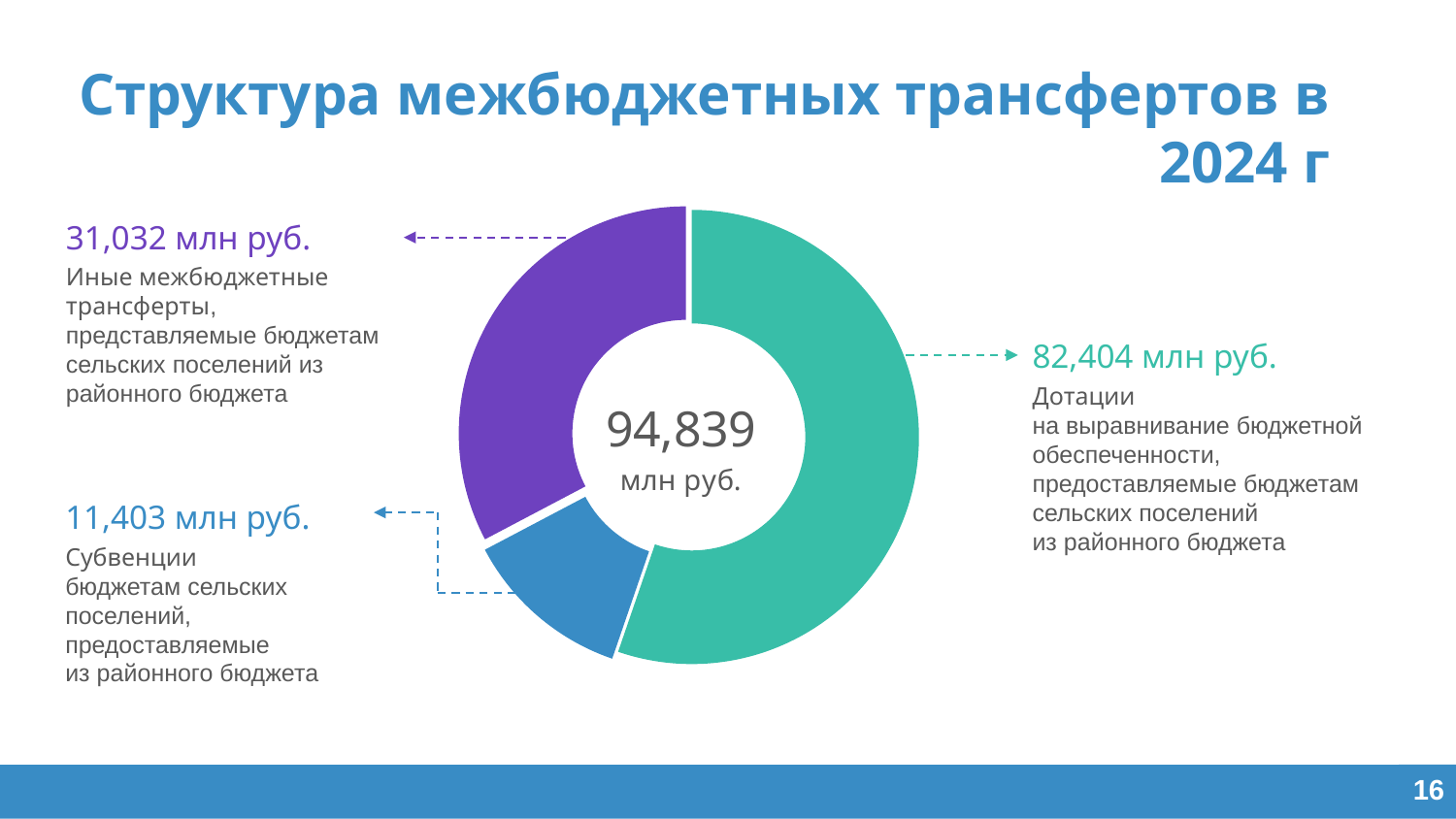
What is the value for Дотации на выравнивание бюджетной обеспеченности? 82,404 млн руб. What is the difference between the value for Иные межбюджетные трансферты (31,032) and the value for Субвенции (11,403)? 19,629 млн руб. How many segments does the donut chart have? 3 What is the value for Субвенции бюджетам сельских поселений? 11,403 млн руб. What kind of chart is shown on the slide? Pie (donut) chart Which is larger: the value for Иные межбюджетные трансферты or the value for Субвенции? Иные межбюджетные трансферты What is the value for Иные межбюджетные трансферты? 31,032 млн руб. What figure is printed in the centre of the donut chart? 94,839 млн руб. Which category has the largest value? Дотации на выравнивание бюджетной обеспеченности What colour is the segment for Дотации на выравнивание бюджетной обеспеченности? Green (teal) Which category has the smallest value? Субвенции бюджетам сельских поселений What is the difference between the value for Дотации (82,404) and the value for Иные межбюджетные трансферты (31,032)? 51,372 млн руб.